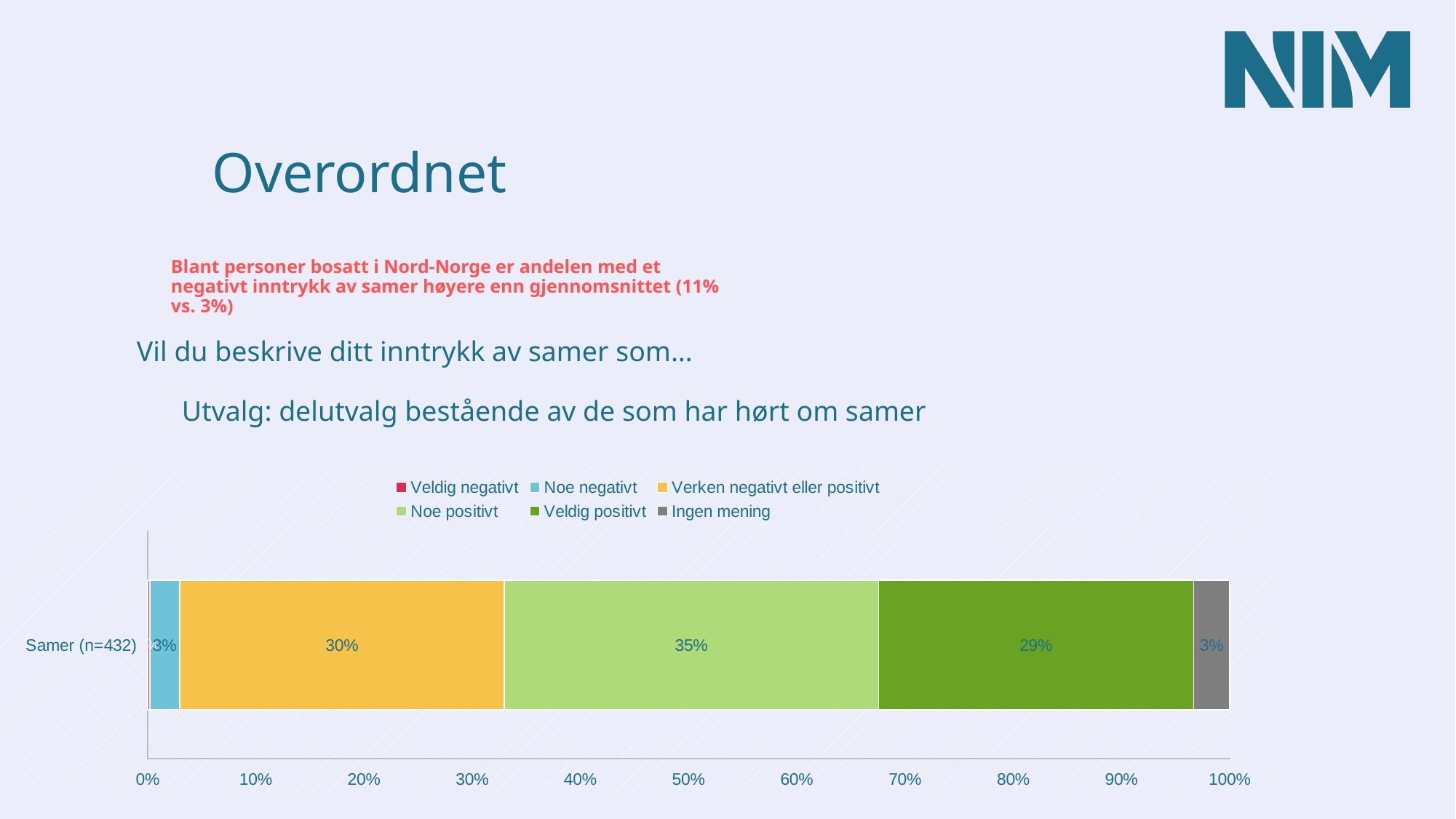
Which is larger: "Verken negativt eller positivt" or "Veldig positivt"? Verken negativt eller positivt What percentage of respondents answered "Noe positivt" in the stacked bar chart? 35% What share of respondents answered "Verken negativt eller positivt"? 30% What is the difference between the "Noe positivt" and "Veldig positivt" values? 6 percentage points What is the difference between the "Verken negativt eller positivt" value and the "Ingen mening" value? 27 percentage points What is the label of the single category on the vertical axis of the chart? Samer (n=432) How many series does the legend of the chart list? 6 Which response category has the largest segment in the bar? Noe positivt What is the value shown for "Veldig positivt" in the chart? 29% What kind of chart is shown on the slide? Stacked bar chart How many bars (categories) are plotted in the chart? 1 What is the value of the "Ingen mening" segment in the chart? 3%